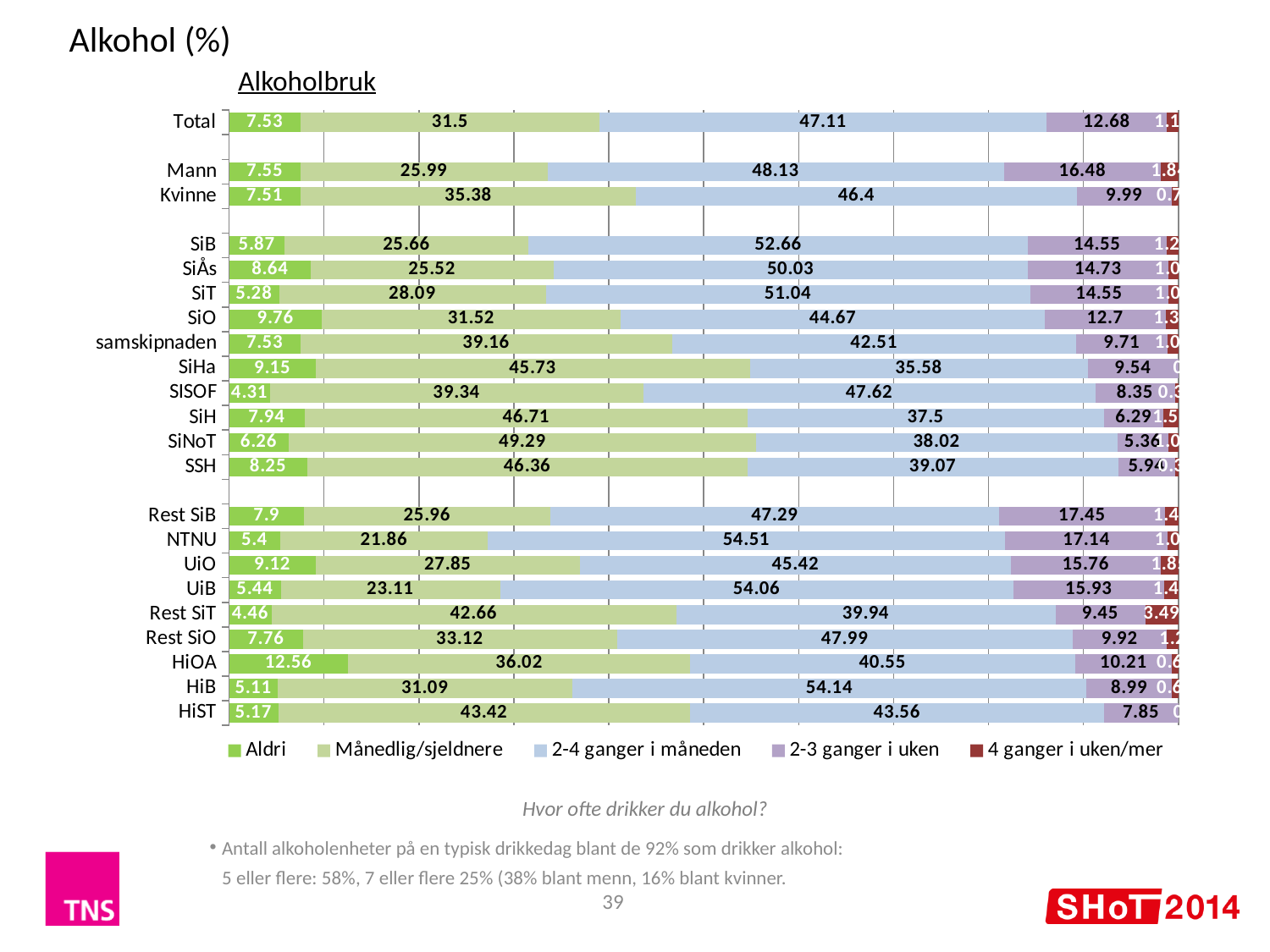
How many series does the legend list? 5 What is the "4 ganger i uken/mer" value for Rest SiT? 3.49 What is the "2-4 ganger i måneden" value for SiB? 52.66 What is the "Aldri" value for HiOA? 12.56 Which category has the highest "Månedlig/sjeldnere" value? SiNoT Which has the larger "Månedlig/sjeldnere" value, Mann or Kvinne? Kvinne Which category has the highest "Aldri" value? HiOA What is the difference between Mann and Kvinne in the "2-3 ganger i uken" series? 6.49 Which category has the lowest "Månedlig/sjeldnere" value? NTNU What is the value for Total in the "2-4 ganger i måneden" series? 47.11 What type of chart is shown on the slide? Stacked bar chart How many categories are shown on the y axis of the chart? 22